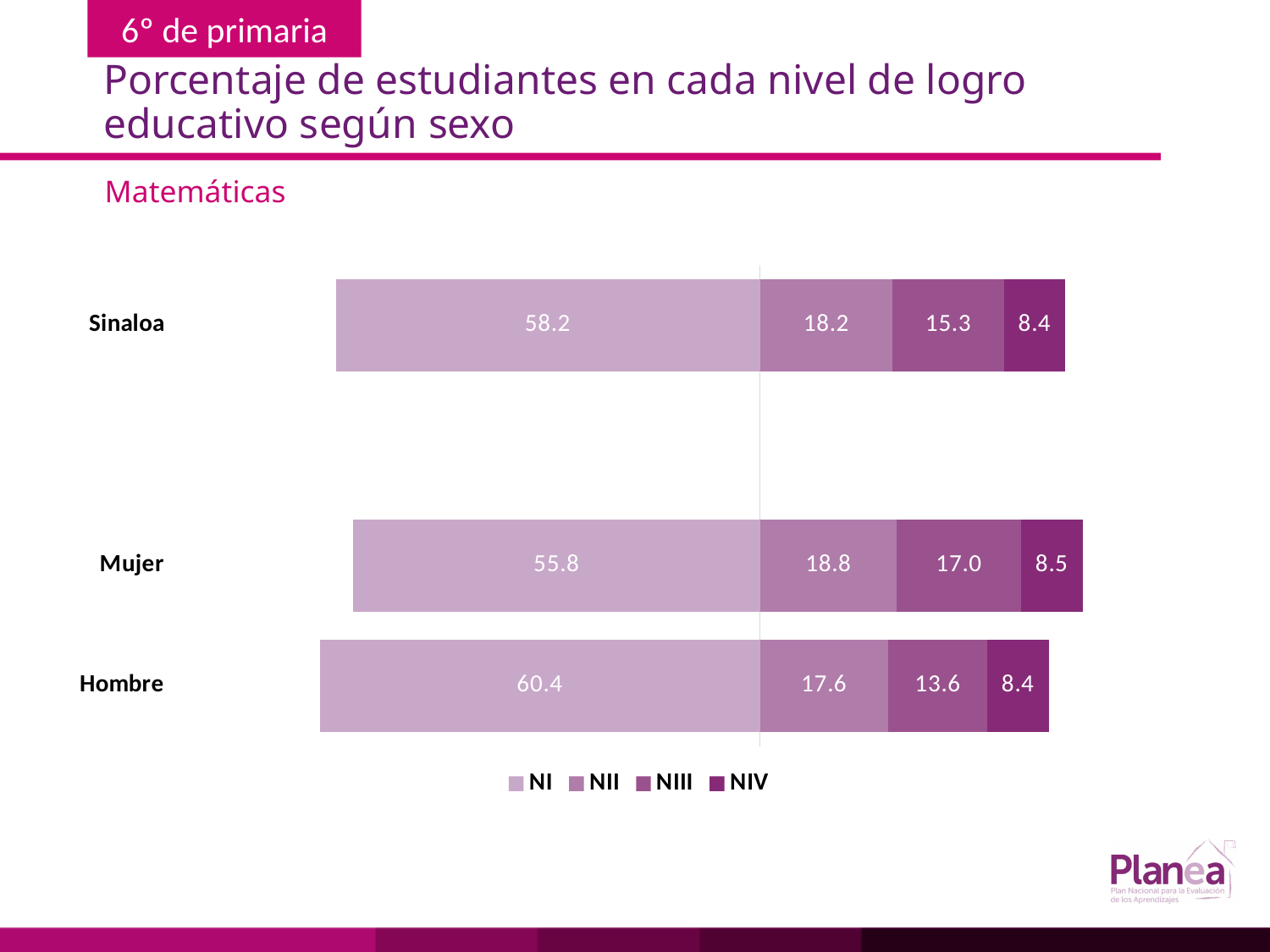
What is the NIV value for Mujer? 8.5 Which category has the highest NI value? Hombre What kind of chart is shown on the slide? Stacked bar chart What is the NI value for Sinaloa? 58.2 What is the NII value for Hombre? 17.6 Which is larger, the NIII value for Mujer or the NIII value for Sinaloa? Mujer How many series does the legend list? 4 What is the NIII value for Mujer? 17.0 What is the difference between the NI values for Hombre and Mujer? 4.6 How many categories are shown in the chart? 3 Which category has the lowest NIII value? Hombre What is the total of the stacked bar for Hombre? 100.0